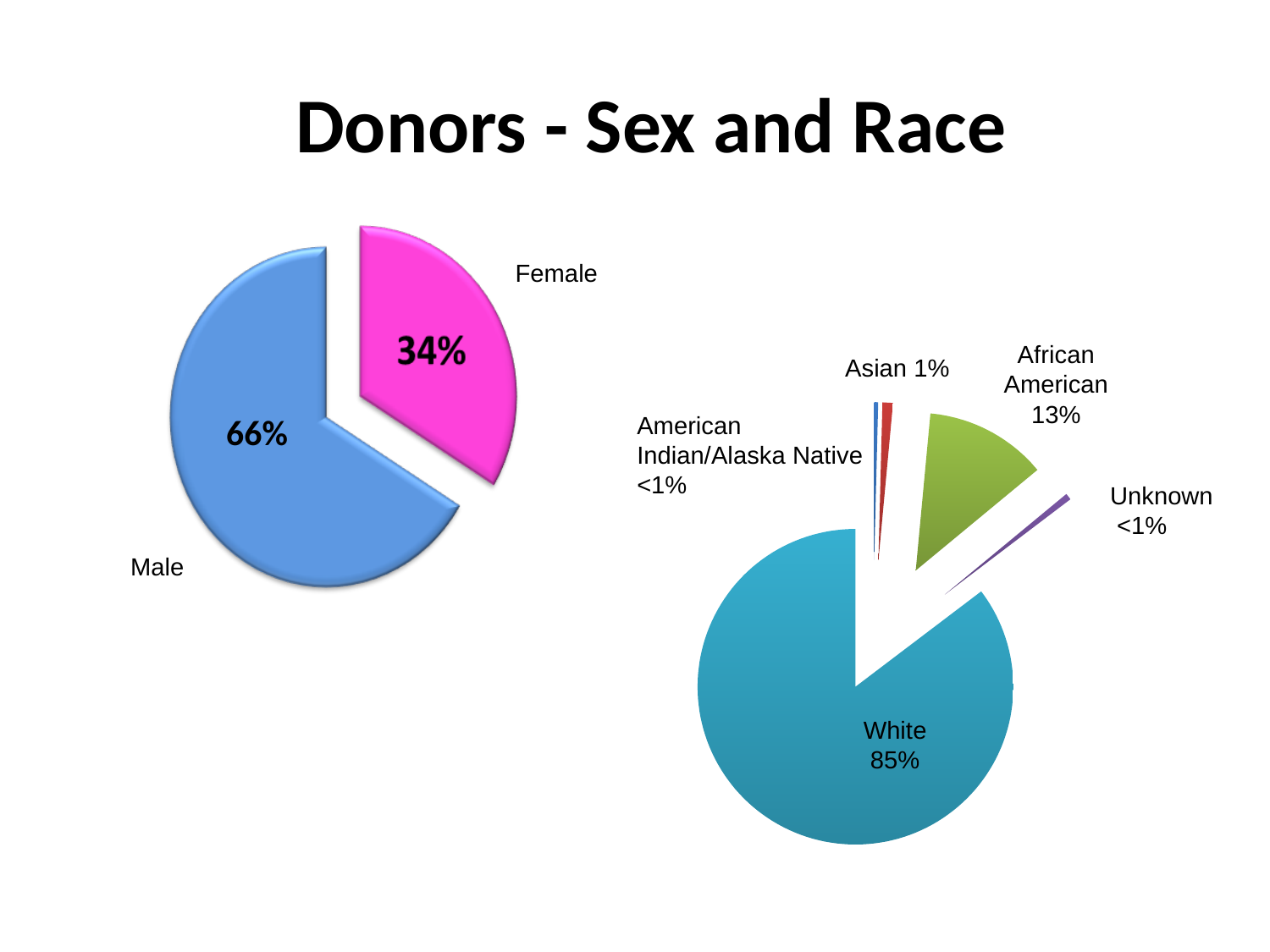
In the right pie chart (race), how many slices are there? 5 In the left pie chart (sex), what percentage of donors are Male? 66% In the right pie chart (race), what percentage of donors are White? 85% In the right pie chart (race), what share is shown for Unknown? <1% In the left pie chart (sex), which category has the larger share? Male What type of chart is used on this slide? Pie chart In the right pie chart (race), which category has the largest share? White In the left pie chart (sex), what percentage of donors are Female? 34% In the left pie chart (sex), what is the difference in percentage points between Male and Female? 32 In the right pie chart (race), what percentage of donors are Asian? 1% In the left pie chart (sex), how many slices are there? 2 In the right pie chart (race), what percentage of donors are African American? 13%